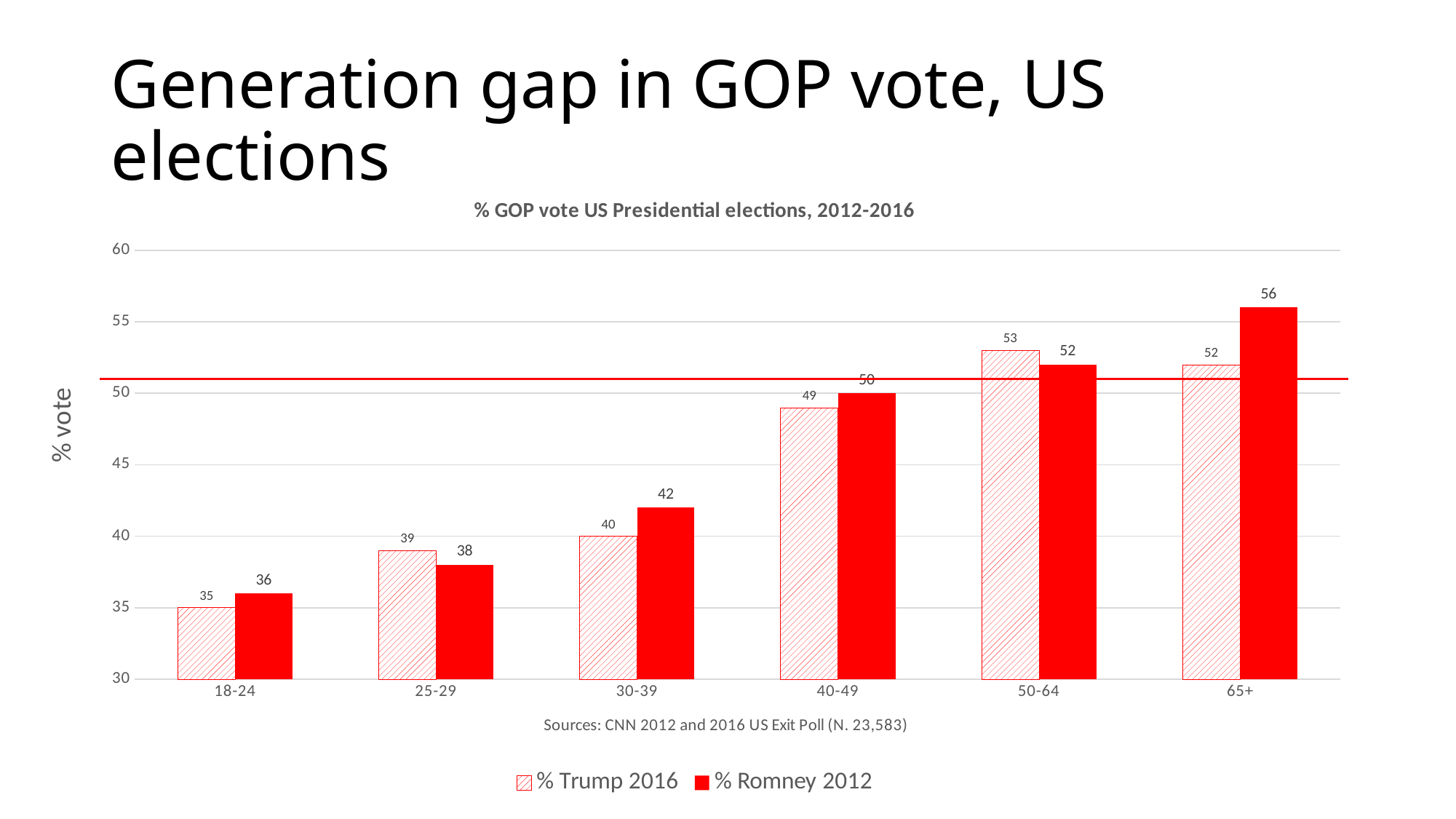
What is the % Romney 2012 value for the 65+ age group? 56 What is the % Romney 2012 value for the 30-39 age group? 42 Which age group has the lowest % Romney 2012 value? 18-24 What is the % Trump 2016 value for the 18-24 age group? 35 Do the % Romney 2012 values rise or fall as age group increases along the x axis? Rise What kind of chart is shown on the slide? Bar chart What is the difference between the % Romney 2012 and % Trump 2016 values for the 65+ age group? 4 What is the title of the chart? % GOP vote US Presidential elections, 2012-2016 How many age groups are shown on the x axis? 6 How many series does the legend list? 2 Which age group has the highest % Trump 2016 value? 50-64 For the 25-29 age group, which is larger: % Trump 2016 or % Romney 2012? % Trump 2016